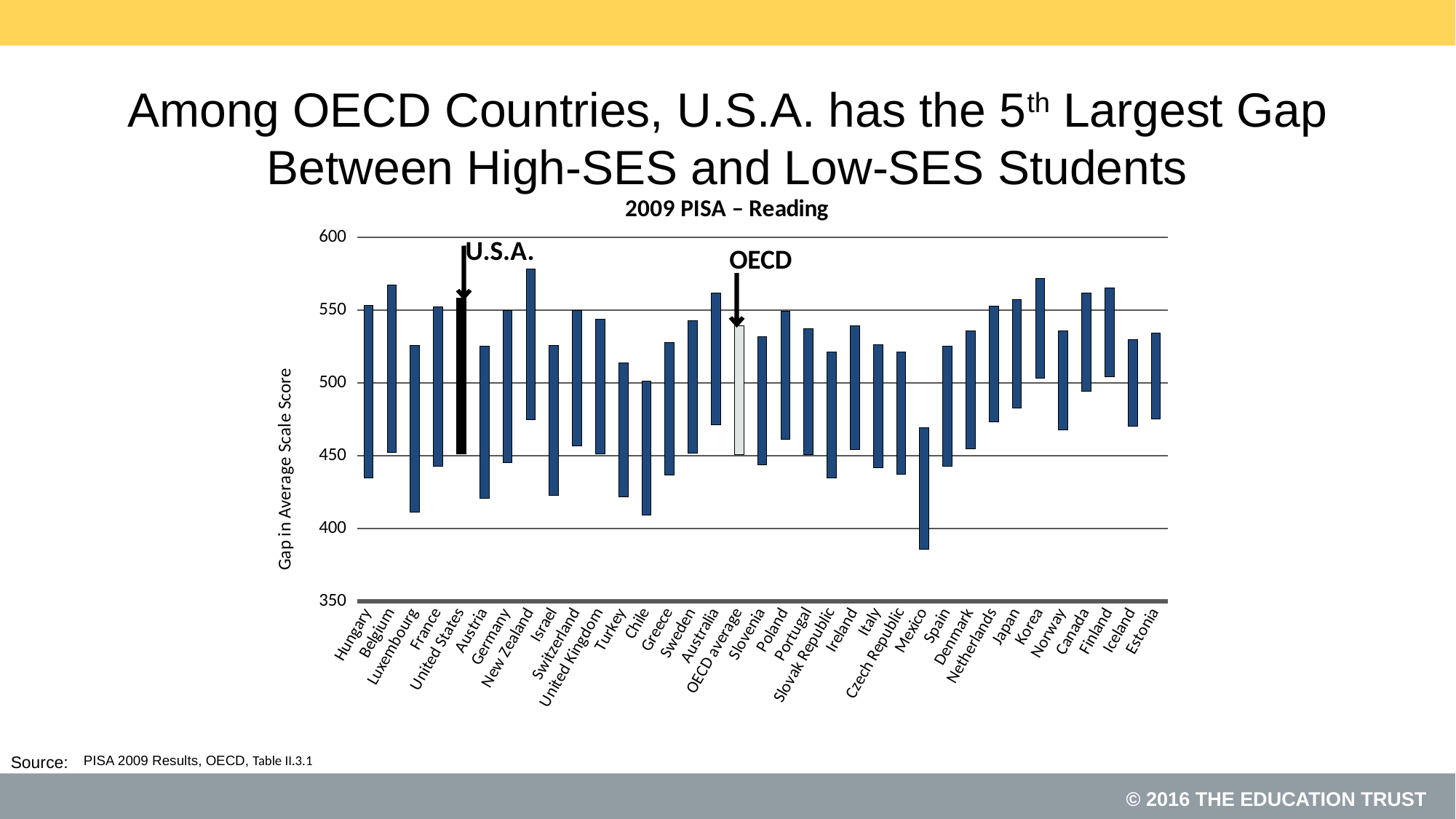
Which country's bar is drawn in black on the chart? United States What is the title of the chart? 2009 PISA – Reading Is the bottom of the Chile bar greater or less than 450? less Is the top of the Korea bar greater or less than 550? greater What is the label on the vertical axis of the chart? Gap in Average Scale Score Is the top of the New Zealand bar greater or less than 550? greater How many countries or groups are listed along the x axis of the chart? 35 Which category has the bar that extends lowest on the chart? Mexico What kind of chart is shown on the slide? bar chart